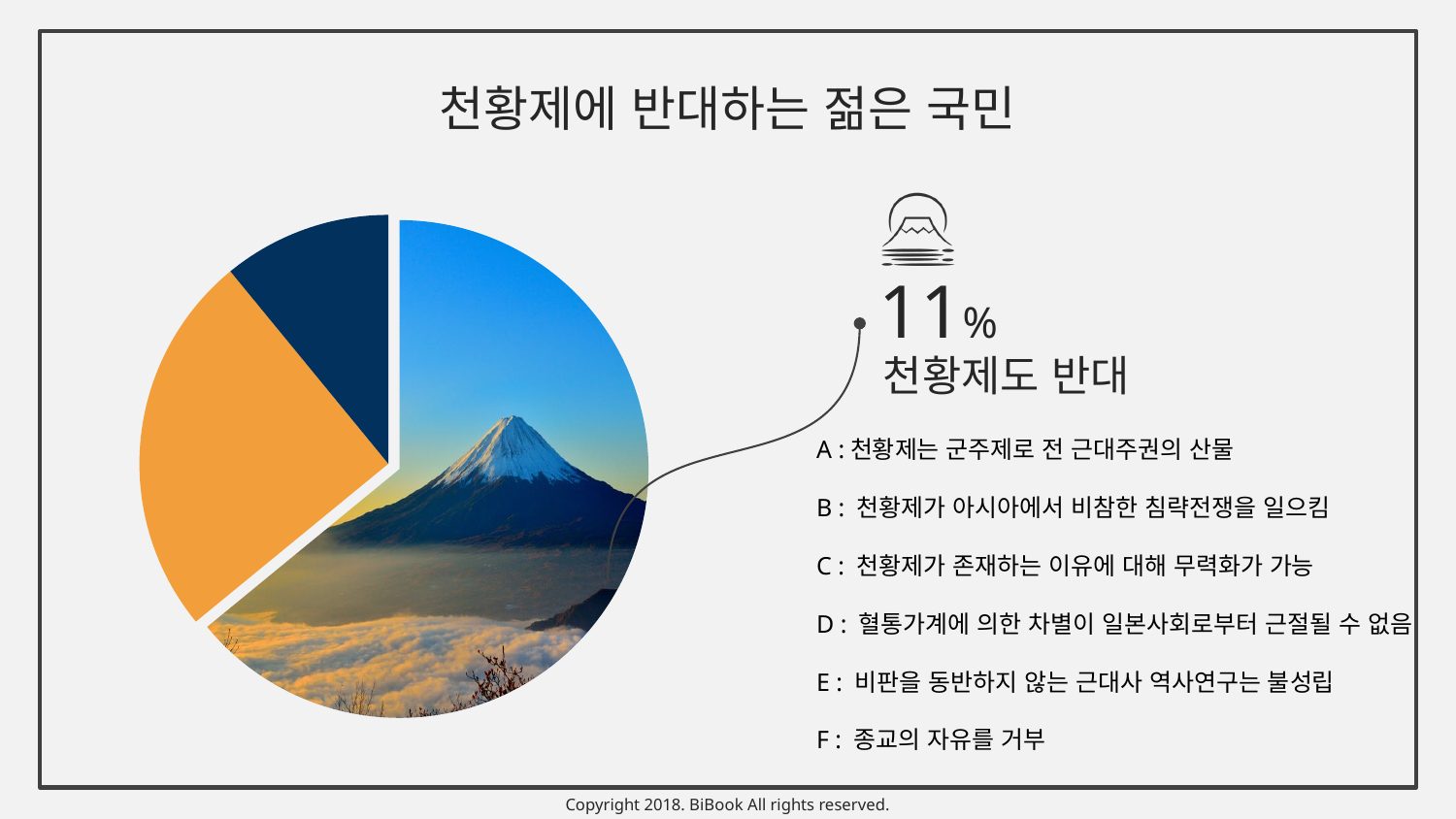
What is the title of the slide containing the pie chart? 천황제에 반대하는 젊은 국민 How many slices does the pie chart have? 3 What kind of chart is shown on the slide? pie chart Which slice is the largest: the photo-filled slice, the orange slice, or the dark navy slice? the photo-filled slice Which is larger, the orange slice or the dark navy slice? the orange slice What percentage is shown for the slice labelled '천황제도 반대'? 11%